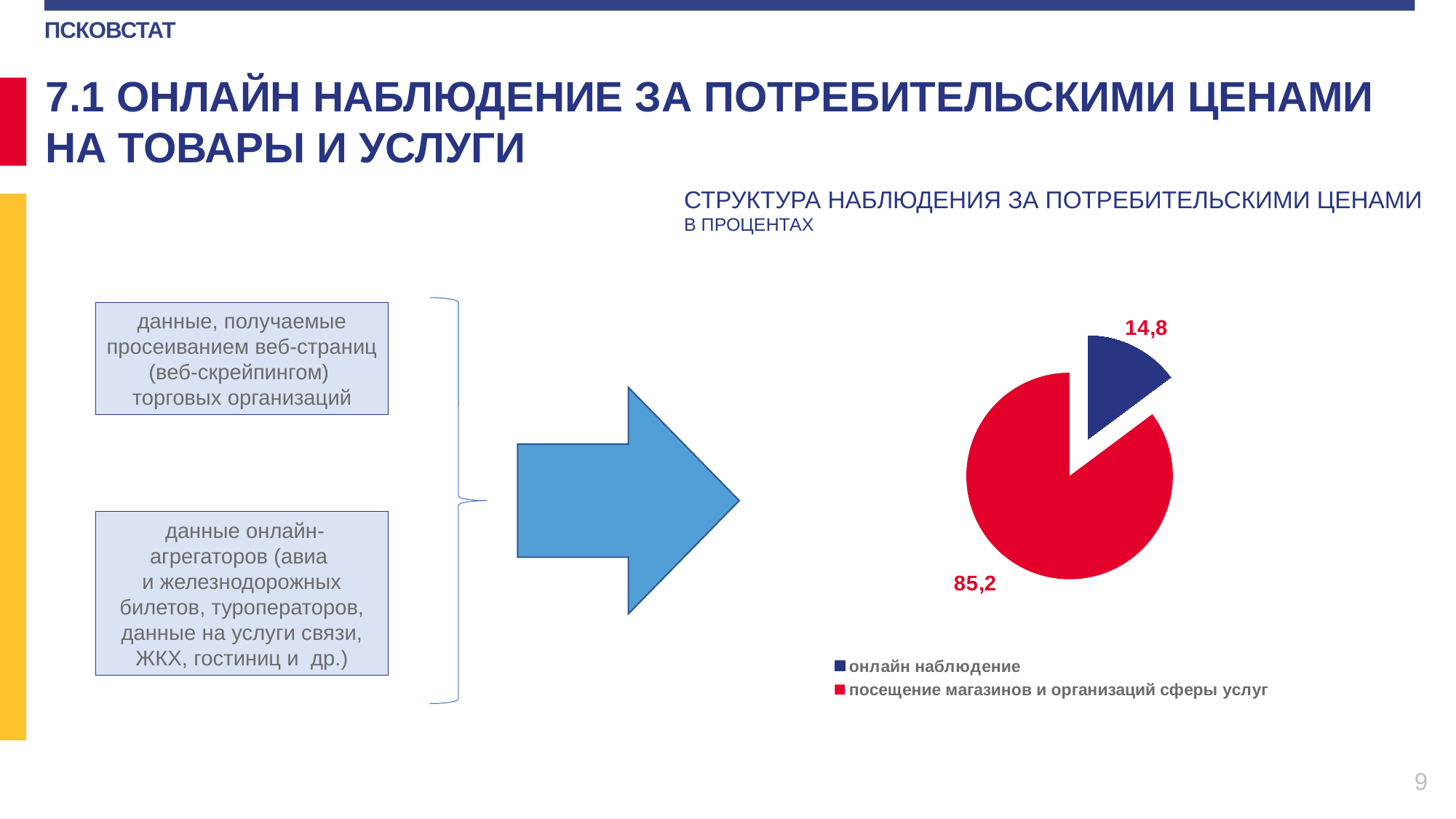
What is the value for посещение магазинов и организаций сферы услуг? 85,2 What is the value for онлайн наблюдение? 14,8 Which category has the largest share of the pie? посещение магазинов и организаций сферы услуг What type of chart is shown on the slide? pie chart How many entries does the legend list? 2 What is the difference between the values for посещение магазинов и организаций сферы услуг and онлайн наблюдение? 70,4 What is the title of the chart? СТРУКТУРА НАБЛЮДЕНИЯ ЗА ПОТРЕБИТЕЛЬСКИМИ ЦЕНАМИ Which category has the smallest share of the pie? онлайн наблюдение What colour is the slice for онлайн наблюдение? dark blue What share of the pie does онлайн наблюдение represent? 14,8% Which is larger: онлайн наблюдение or посещение магазинов и организаций сферы услуг? посещение магазинов и организаций сферы услуг How many slices does the pie chart have? 2